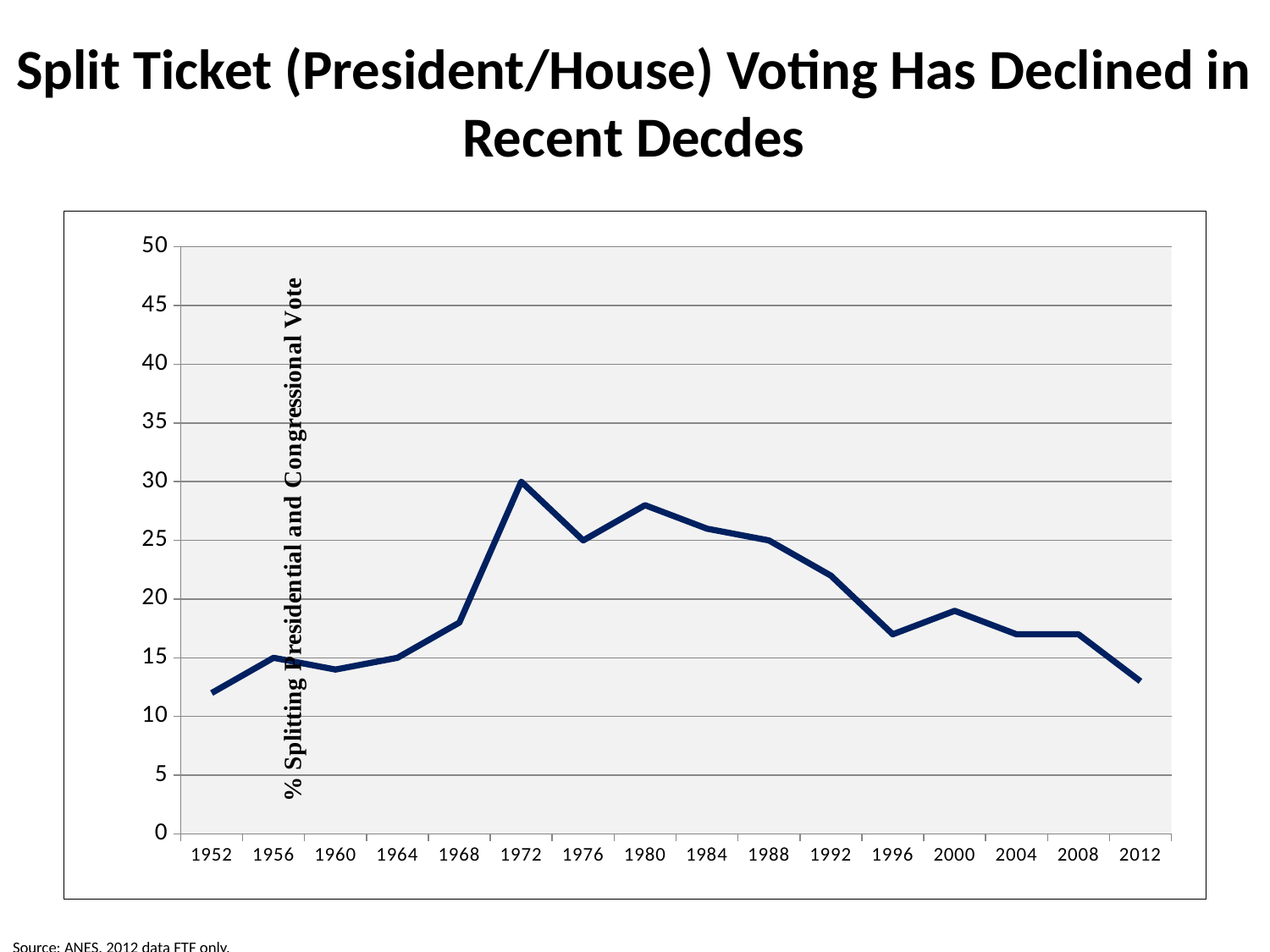
Is the value for 1952 greater or less than 15? less How many years are plotted along the x axis? 16 Which year has the larger value, 1980 or 1996? 1980 In which year does the percentage splitting presidential and congressional vote reach its highest point? 1972 Do the values rise or fall from 1988 to 1996? fall What is the label on the vertical axis? % Splitting Presidential and Congressional Vote What is the value for 1972? 30 Is the value for 1980 greater or less than 25? greater What kind of chart is shown on the slide? line chart Is the value for 2012 greater or less than 15? less What is the value for 1988? 25 What is the value for 1976? 25